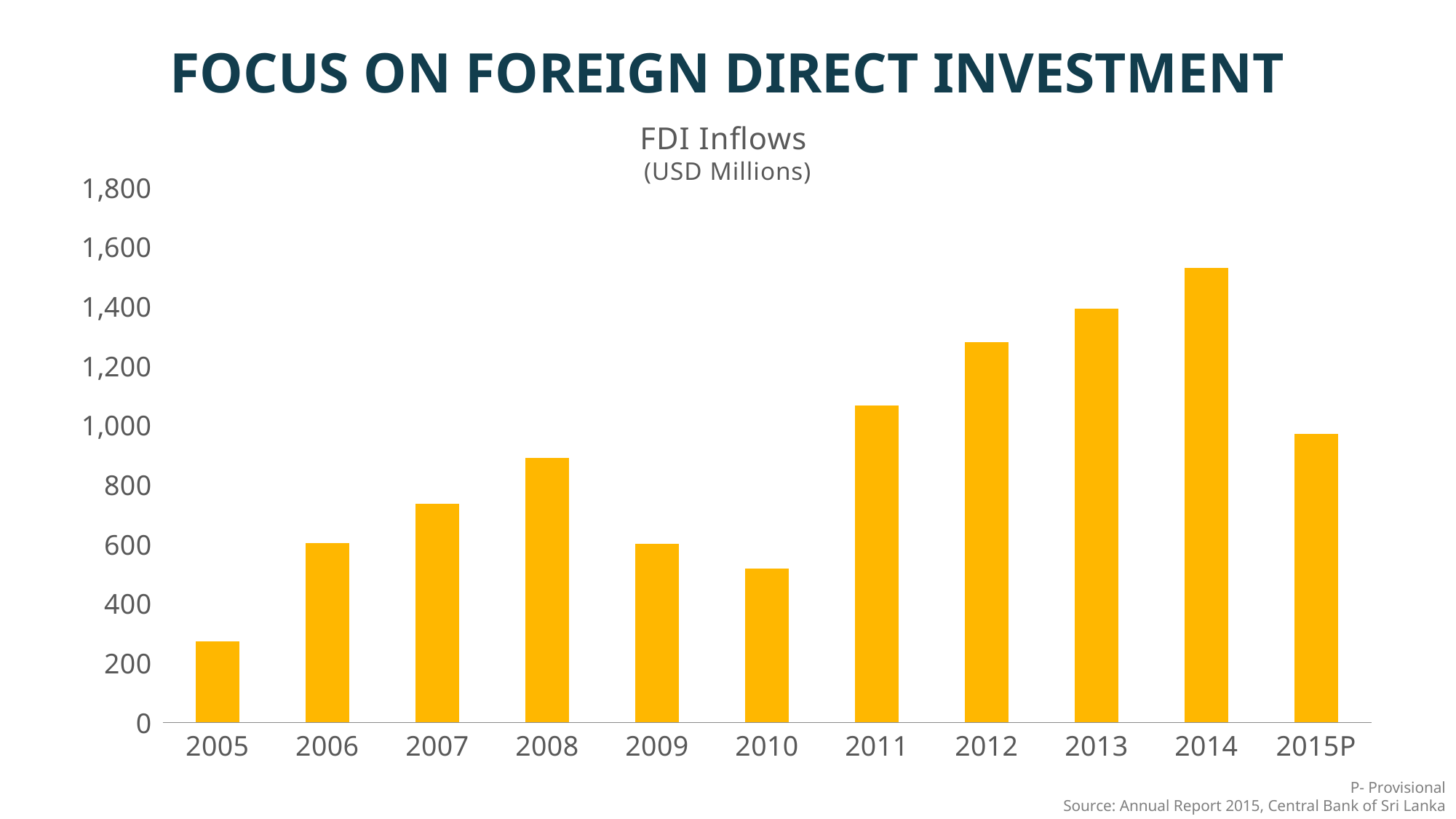
Is the value for 2005 greater or less than 400? less Is the value for 2010 greater or less than 600? less Is the value for 2014 greater or less than 1,400? greater Do FDI inflows rise or fall from 2010 to 2014? Rise Which year has the highest FDI inflows? 2014 What kind of chart is shown on the slide? Bar chart Which year has the lowest FDI inflows? 2005 How many years are shown on the x axis of the chart? 11 What is the title of the chart? FDI Inflows In what units are the FDI inflows shown? USD Millions Which year has higher FDI inflows, 2008 or 2007? 2008